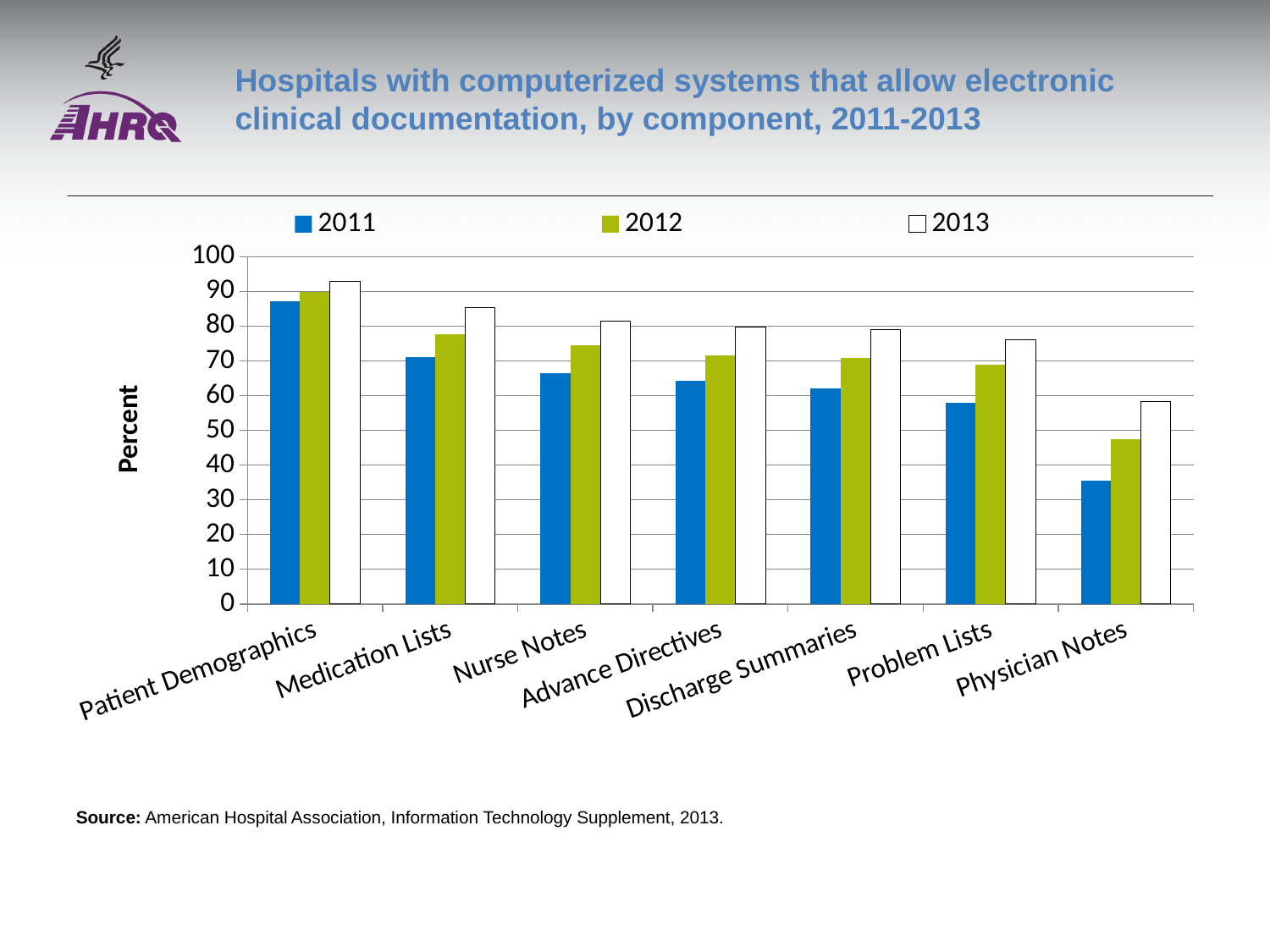
Within each component, do the values rise or fall from 2011 to 2013? rise What kind of chart is shown on the slide? Bar chart Is the value for Medication Lists in 2013 greater or less than 80? greater Is the value for Physician Notes in 2011 greater or less than 40? less How many component categories are shown on the x axis? 7 Which is larger for 2011: Medication Lists or Problem Lists? Medication Lists How many series does the legend list? 3 Do the 2013 values rise or fall moving from Patient Demographics to Physician Notes along the x axis? fall What is the label on the y axis? Percent Is the value for Discharge Summaries in 2011 greater or less than 70? less Which component has the lowest value for 2011? Physician Notes Which component has the highest value for 2013? Patient Demographics